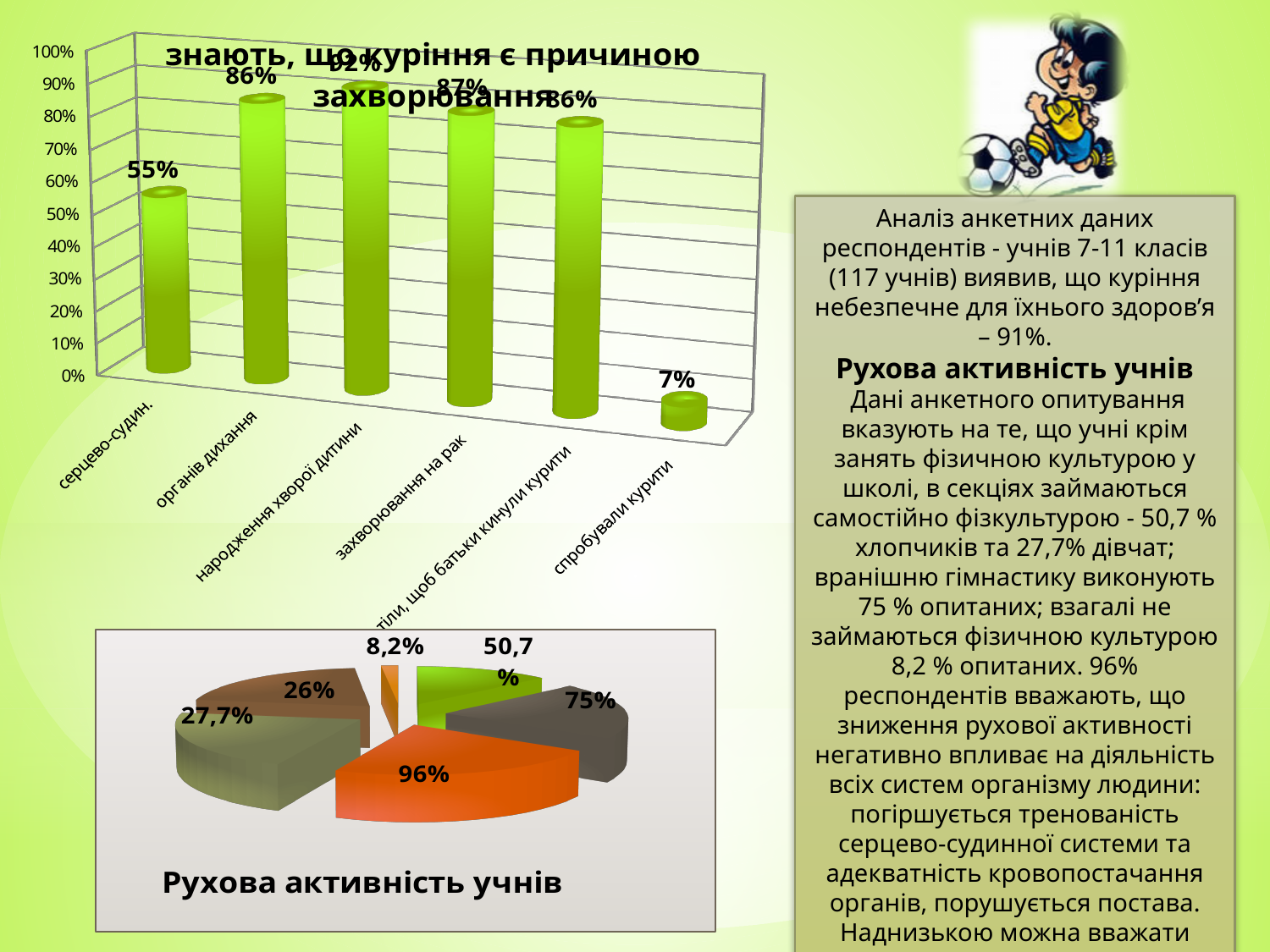
In the top bar chart, what is the value for 'органів дихання'? 86% In the top bar chart, what is the difference between the values for 'органів дихання' and 'серцево-судин.'? 31 percentage points What kind of chart is the top chart on the slide? bar chart In the top bar chart, what is the value for 'захворювання на рак'? 87% In the top bar chart, is the value for 'серцево-судин.' greater or less than 50%? greater In the top bar chart, what is the value for 'спробували курити'? 7% In the top bar chart, which category has the lowest value? спробували курити In the pie chart 'Рухова активність учнів', what is the largest value labelled on a slice? 96% How many categories are shown in the top bar chart? 6 In the top bar chart, what is the value for 'серцево-судин.'? 55% In the top bar chart, which is larger: the value for 'серцево-судин.' or for 'органів дихання'? органів дихання What kind of chart is the chart titled 'Рухова активність учнів'? pie chart